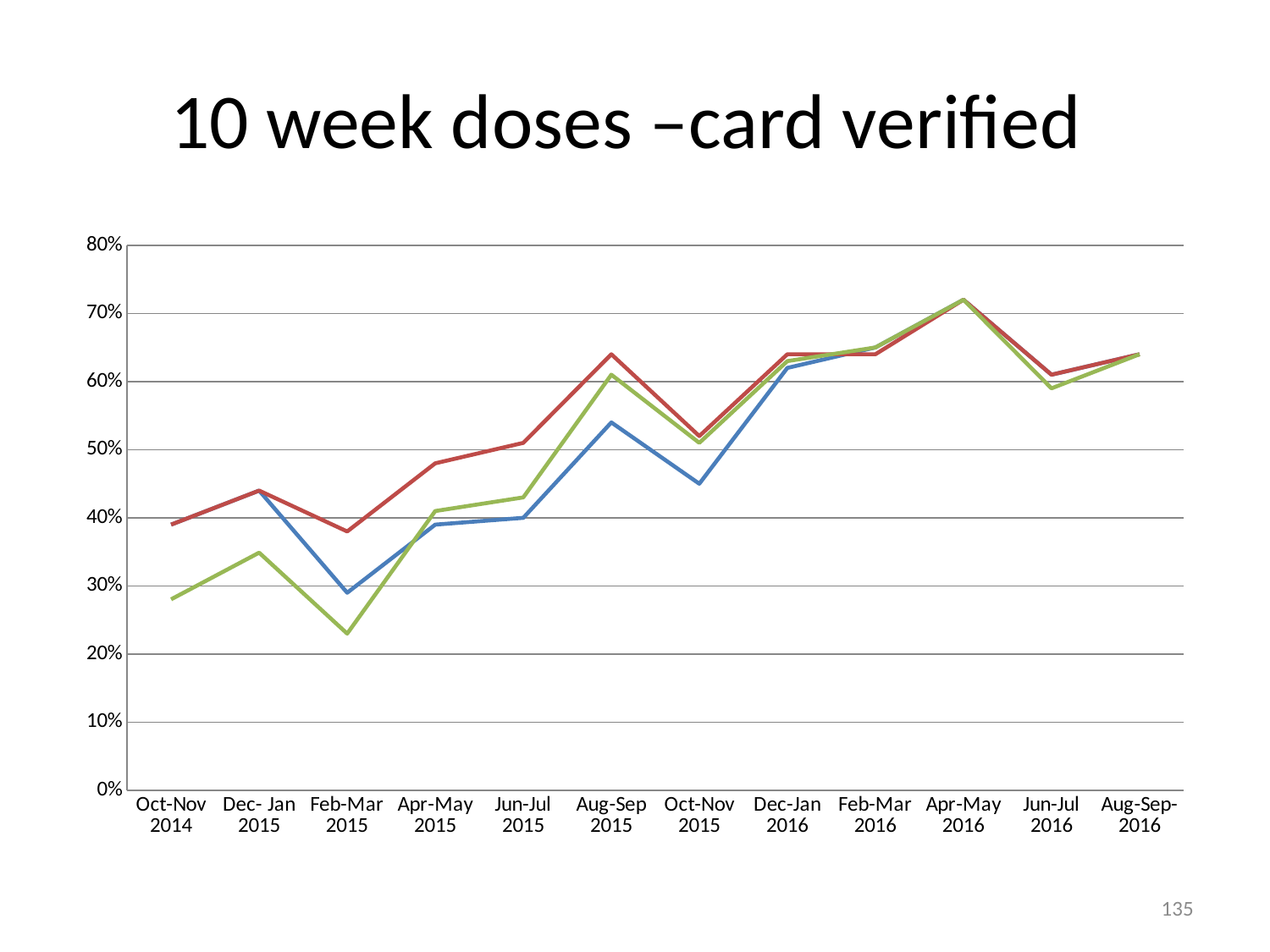
At which period does the red line reach its highest value? Apr-May 2016 What is the title of the chart? 10 week doses –card verified Is the value of the blue line at Feb-Mar 2015 greater or less than 40%? less Overall, do the values of the red line rise or fall from Oct-Nov 2014 to Aug-Sep 2016? rise Is the value of the red line at Apr-May 2016 greater or less than 70%? greater How many lines are plotted on the chart? 3 What kind of chart is shown on the slide? line chart At which period does the green line reach its lowest value? Feb-Mar 2015 How many time periods are shown along the x axis? 12 At Oct-Nov 2014, which line has the higher value, the red line or the green line? red line Is the value of the red line at Aug-Sep 2015 greater or less than 60%? greater